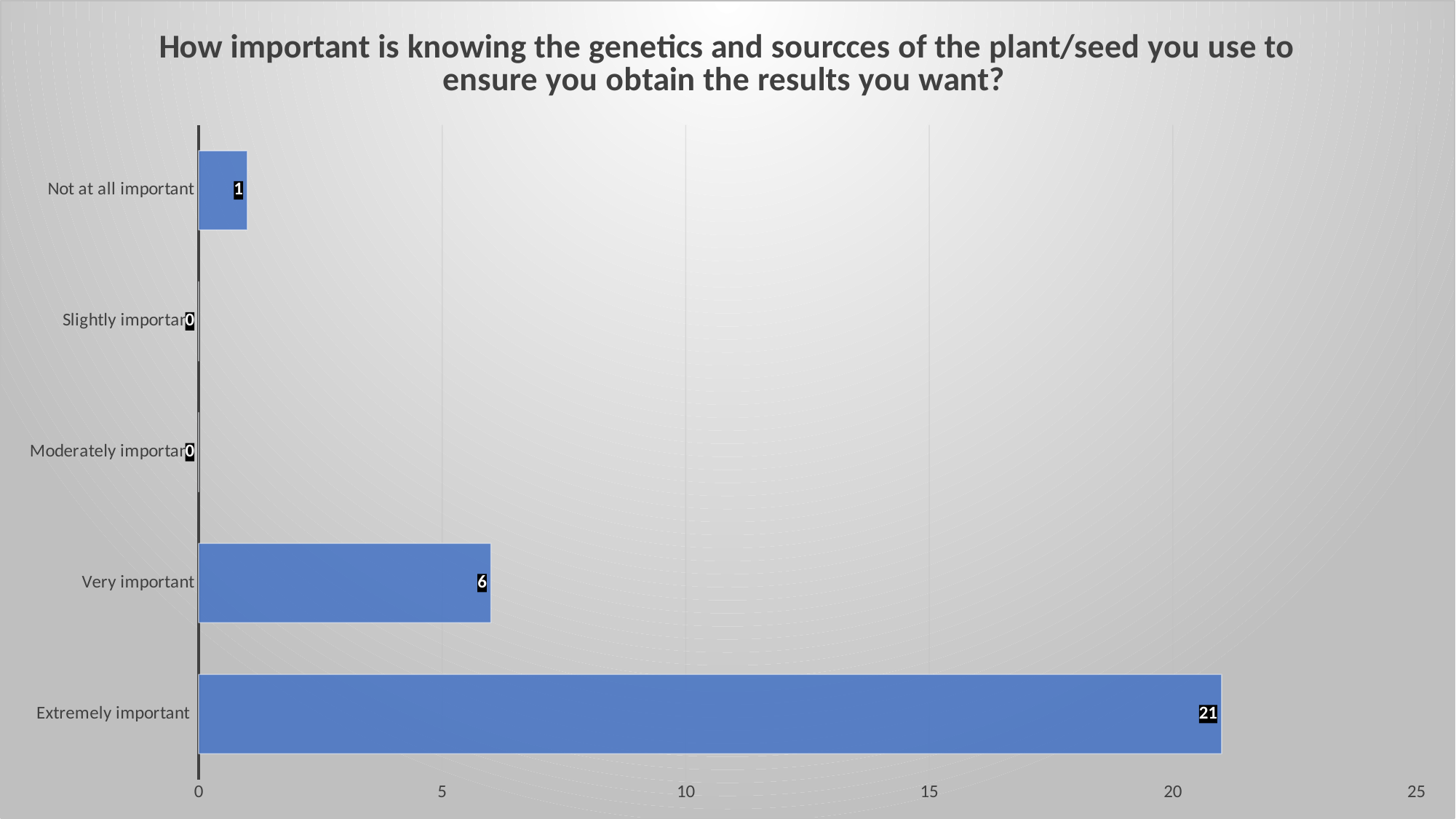
What is the value for Extremely important? 21 Which category has the highest value? Extremely important What is the value for Very important? 6 Is the value for Extremely important greater or less than 20? greater How many categories have a value of 0? 2 What is the value for Not at all important? 1 Which is larger, the value for Very important or the value for Not at all important? Very important What is the value for Slightly important? 0 How many categories are shown on the chart? 5 What is the maximum value shown on the horizontal axis? 25 What kind of chart is shown on the slide? bar chart What is the difference between the values for Extremely important and Very important? 15